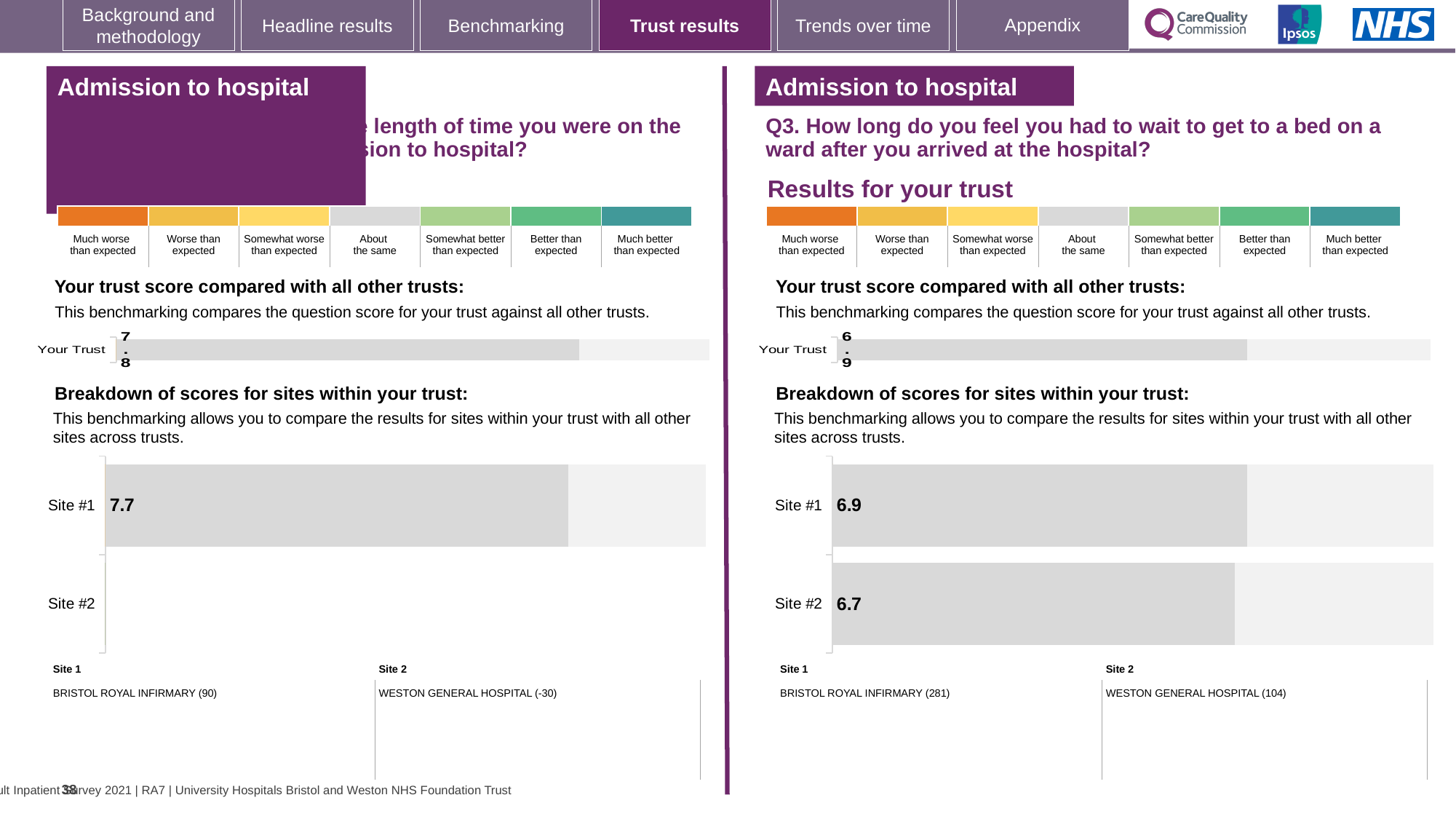
In the right panel (Q3) 'Breakdown of scores for sites within your trust' chart, what is the score for Site #2? 6.7 What type of chart is used for the site breakdown in the right panel (Q3)? Bar chart How many sites are listed in the right panel (Q3) site breakdown chart? 2 In the left panel, what score is shown for Your Trust in the 'Your trust score compared with all other trusts' chart? 7.8 In the right panel (Q3) 'Breakdown of scores for sites within your trust' chart, what is the score for Site #1? 6.9 In the left panel 'Breakdown of scores for sites within your trust' chart, what is the score for Site #1? 7.7 In the right panel (Q3), what score is shown for Your Trust in the 'Your trust score compared with all other trusts' chart? 6.9 What is the difference between the Your Trust score (7.8) and the Site #1 score (7.7) in the left panel? 0.1 In the right panel (Q3) site breakdown chart, which site has the higher score, Site #1 or Site #2? Site #1 In the right panel (Q3) site breakdown chart, which site has the lowest score? Site #2 In the right panel (Q3) site breakdown chart, what is the difference between the Site #1 and Site #2 scores? 0.2 Which panel shows the higher Your Trust score, the left panel or the right panel (Q3)? Left panel